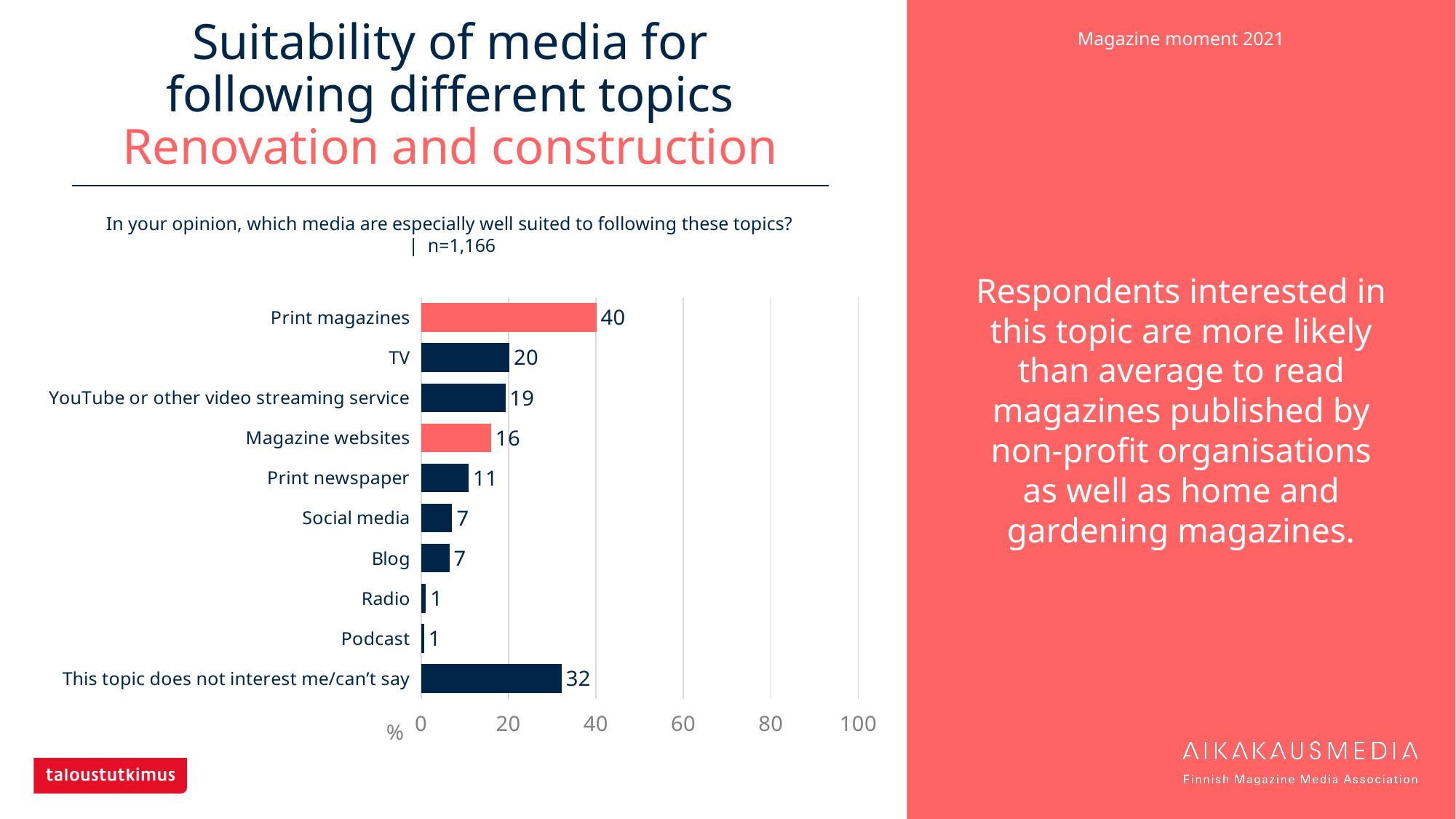
What is the value for Social media? 7 What kind of chart is shown on the slide? Bar chart What is the difference between the values for Print magazines and TV? 20 Which media category has the highest value? Print magazines What is the value for 'This topic does not interest me/can't say'? 32 What is the value for Magazine websites? 16 Which two categories are shown with pink bars instead of dark blue? Print magazines and Magazine websites What is the value for Print magazines? 40 How many categories are shown in the chart? 10 Is the value for Print magazines greater or less than 20? greater Which is larger, the value for YouTube or other video streaming service or the value for Print newspaper? YouTube or other video streaming service What is the sample size (n) stated above the chart? n=1,166